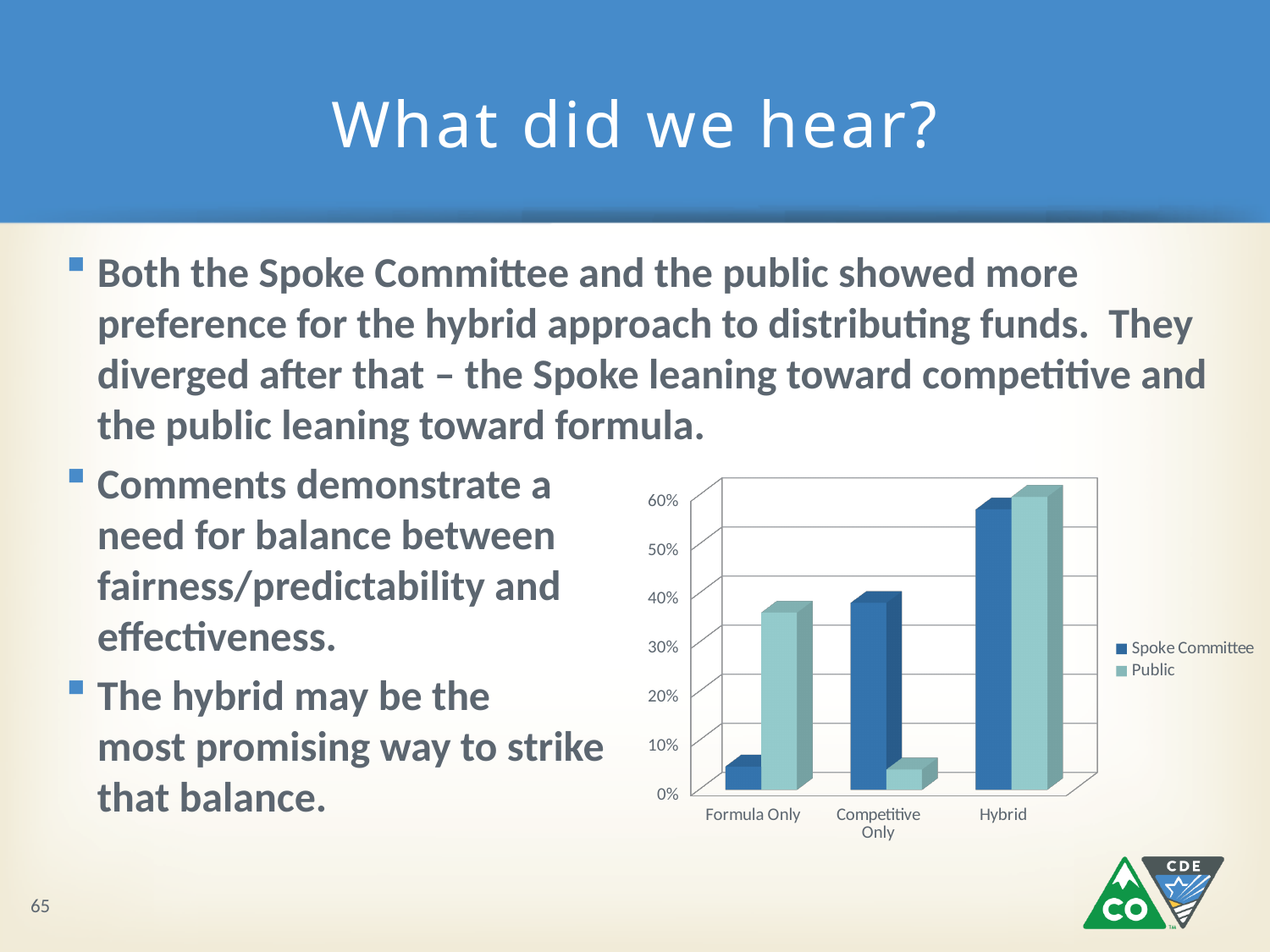
Is the Spoke Committee value for Hybrid greater or less than 50%? greater How many series does the chart's legend list? 2 Which category has the highest value for the Spoke Committee series? Hybrid What kind of chart is shown on the slide? bar chart Is the Public value for Formula Only greater or less than 30%? greater For Competitive Only, which series has the larger value, Spoke Committee or Public? Spoke Committee Which category has the lowest value for the Public series? Competitive Only For Formula Only, which series has the larger value, Spoke Committee or Public? Public Is the Spoke Committee value for Formula Only greater or less than 10%? less Which category has the lowest value for the Spoke Committee series? Formula Only Which series is shown in dark blue in the chart's legend? Spoke Committee How many categories are shown on the x axis of the chart? 3